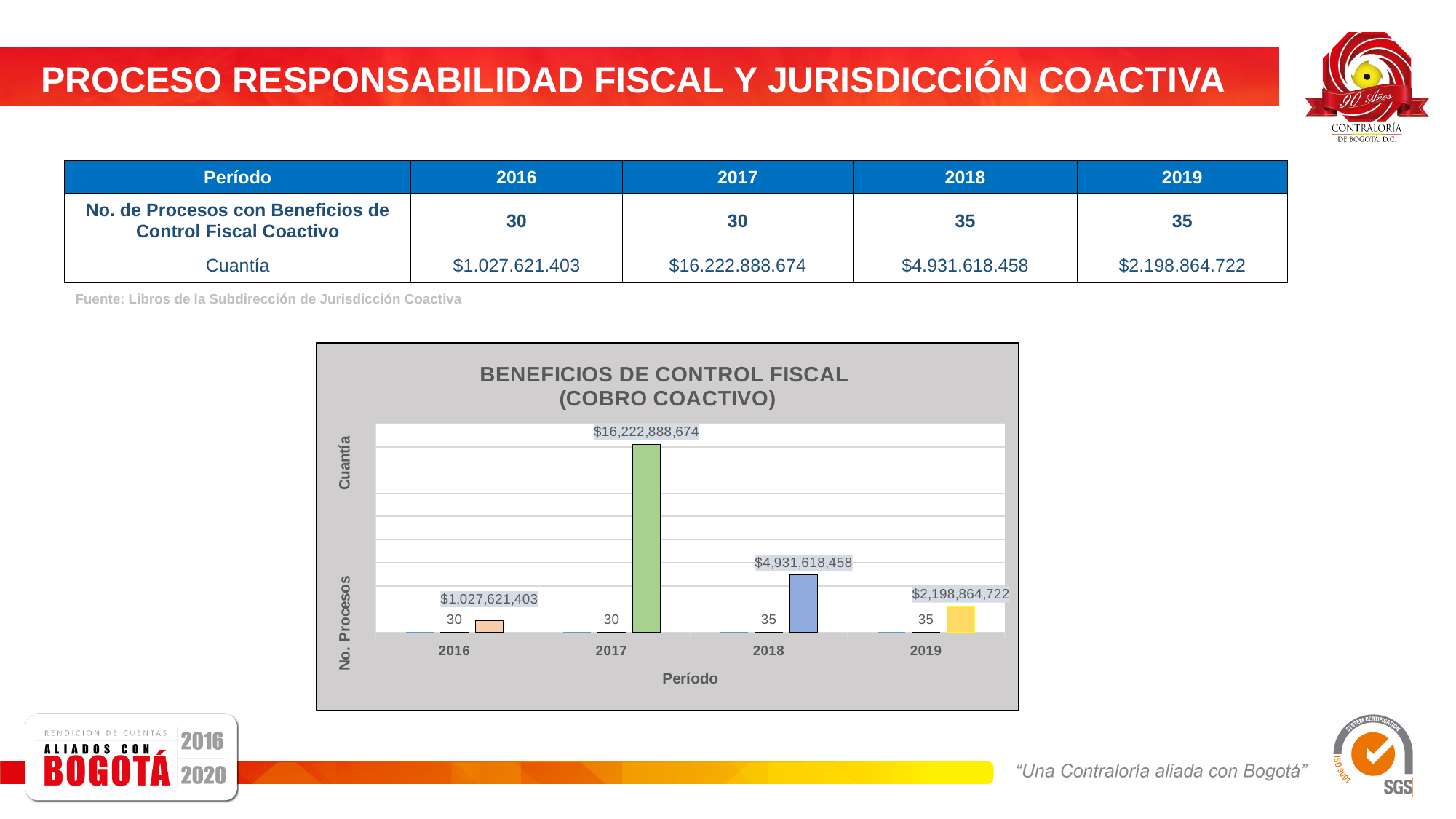
Which year has the highest Cuantía in the chart? 2017 What is the difference between the Cuantía for 2018 and the Cuantía for 2019? $2,732,753,736 Does the Cuantía rise or fall from 2017 to 2019 in the chart? fall What is the Cuantía value shown for 2019 in the chart? $2,198,864,722 What type of chart is shown on the slide? bar chart How many periods (years) are shown on the x axis of the chart? 4 What is the title of the chart? BENEFICIOS DE CONTROL FISCAL (COBRO COACTIVO) Which is larger, the Cuantía for 2016 or the Cuantía for 2019? 2019 What is the No. Procesos value shown for 2018 in the chart? 35 What is the difference between the Cuantía for 2017 and the Cuantía for 2018? $11,291,270,216 Which year has the lowest Cuantía in the chart? 2016 What is the Cuantía value shown for 2017 in the chart? $16,222,888,674